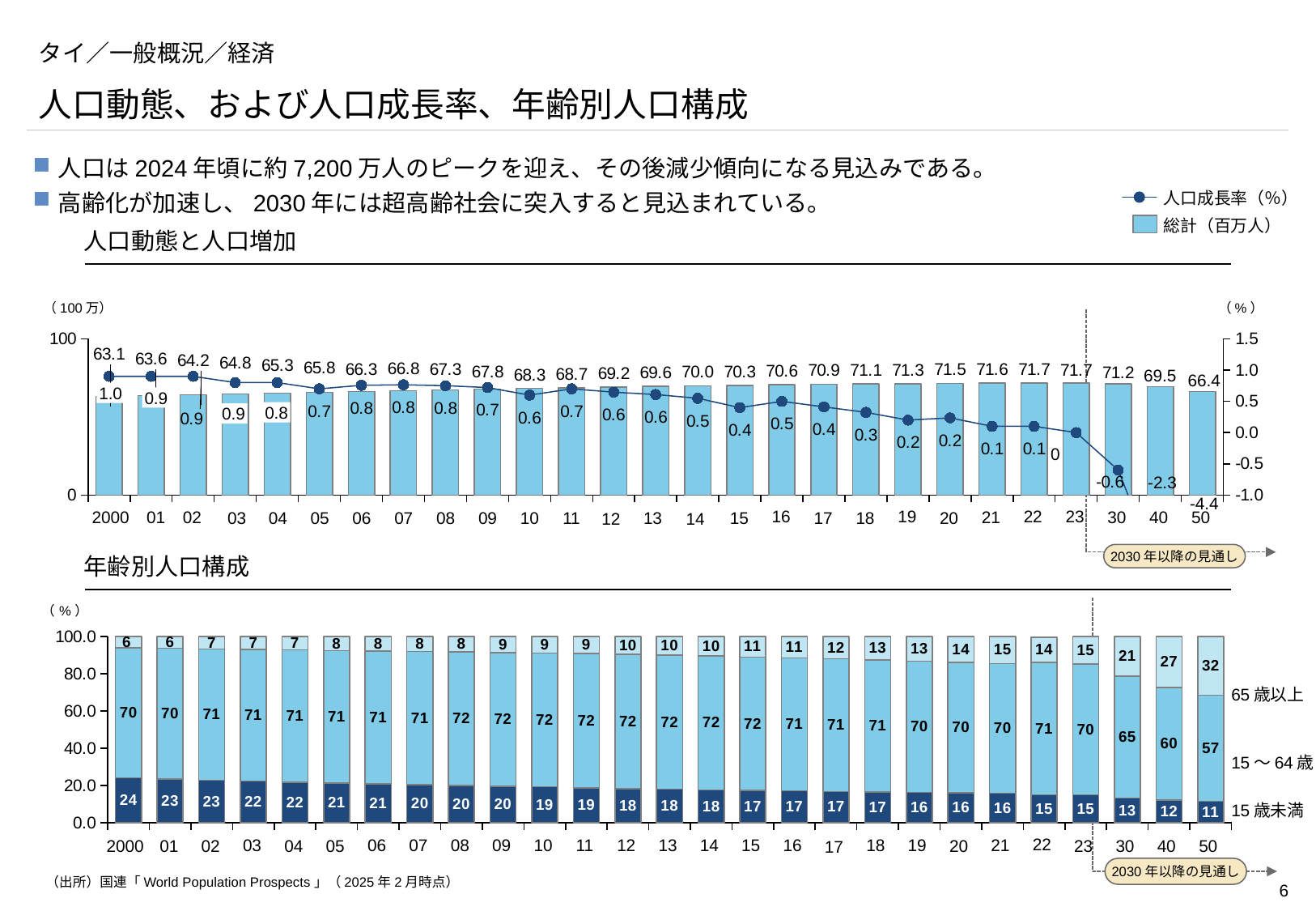
In the top chart (人口動態と人口増加), how many years are shown on the x axis? 27 In the bottom chart (年齢別人口構成), what is the total of the stacked bar for 2000? 100 In the top chart (人口動態と人口増加), what is the population growth rate (人口成長率) shown for 40 (2040)? -2.3 In the top chart (人口動態と人口増加), which has the larger total population, 30 (2030) or 40 (2040)? 30 (2030) In the top chart (人口動態と人口増加), what is the difference between the total population in 50 (2050) and in 2000? 3.3 In the top chart (人口動態と人口増加), which year has the lowest population growth rate? 50 (2050) How many series does the legend of the top chart (人口動態と人口増加) list? 2 What kind of chart is the bottom chart (年齢別人口構成)? Stacked bar chart In the bottom chart (年齢別人口構成), what is the share of 65歳以上 in 50 (2050)? 32 In the top chart (人口動態と人口増加), which year has the lowest total population value? 2000 In the bottom chart (年齢別人口構成), does the share of 15歳未満 rise or fall from 2000 to 50 (2050)? Fall In the top chart (人口動態と人口増加), what is the total population (総計, 百万人) shown for 2000? 63.1